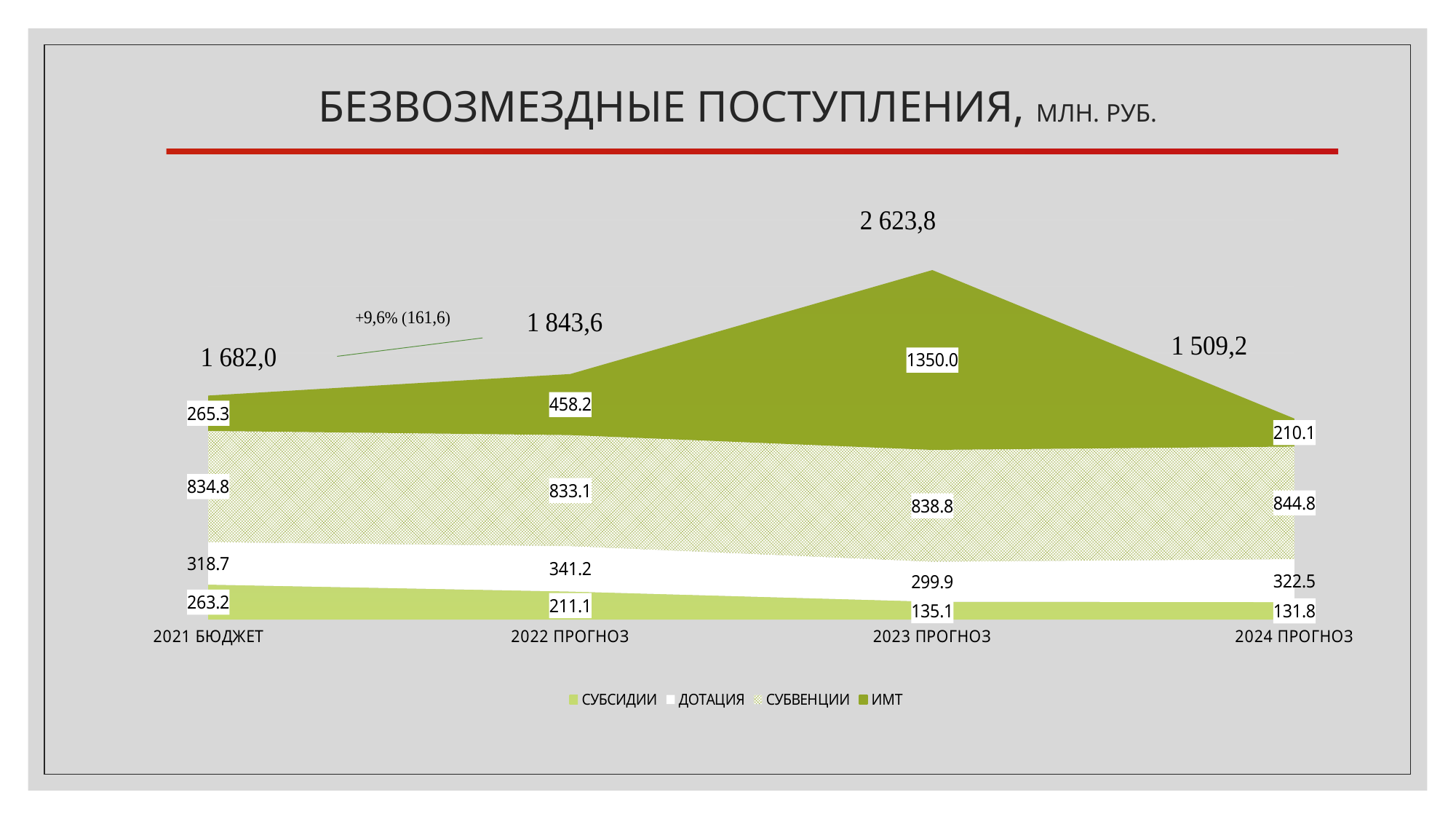
What is the value of СУБВЕНЦИИ for 2022 ПРОГНОЗ? 833.1 What is the value of ИМТ for 2023 ПРОГНОЗ? 1350.0 In which year is the value of ИМТ highest? 2023 ПРОГНОЗ How many categories are shown on the x axis? 4 How many series does the legend list? 4 What is the value of ДОТАЦИЯ for 2024 ПРОГНОЗ? 322.5 Does the value of СУБСИДИИ rise or fall from 2021 БЮДЖЕТ to 2024 ПРОГНОЗ? fall In which year is the value of СУБСИДИИ lowest? 2024 ПРОГНОЗ What is the difference between the ИМТ values for 2022 ПРОГНОЗ and 2021 БЮДЖЕТ? 192.9 What is the value of СУБСИДИИ for 2021 БЮДЖЕТ? 263.2 What is the total of all series for 2023 ПРОГНОЗ? 2 623,8 Which is larger: ДОТАЦИЯ for 2022 ПРОГНОЗ or ДОТАЦИЯ for 2023 ПРОГНОЗ? 2022 ПРОГНОЗ